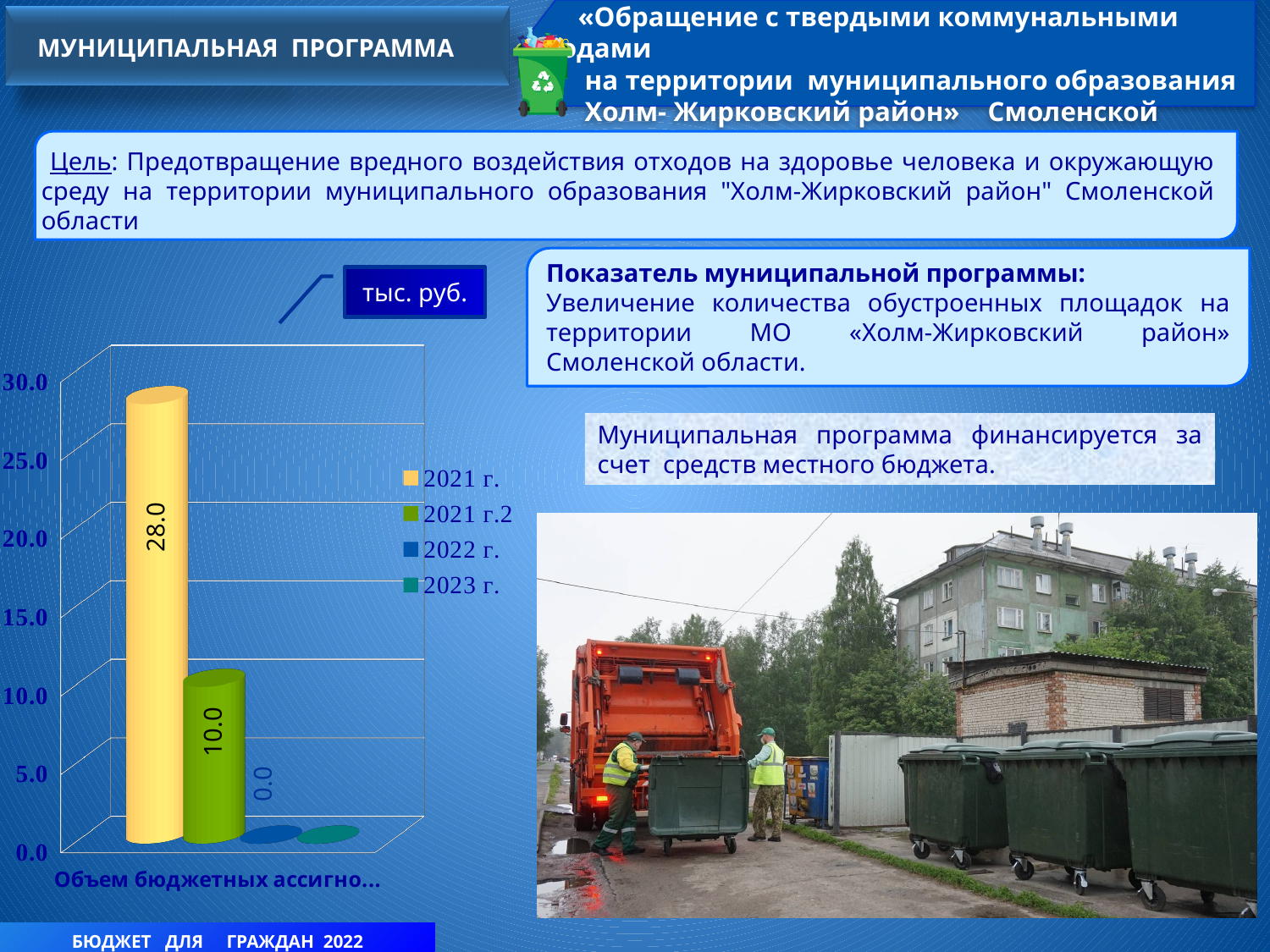
What is the value for the series "2021 г." in the chart? 28.0 Is the value for "2021 г.2" greater or less than 15.0? less What is the difference between the values for "2021 г." and "2021 г.2"? 18.0 Which is larger, the value for "2021 г." or the value for "2021 г.2"? 2021 г. What is the value for the series "2022 г." in the chart? 0.0 What kind of chart is shown on the slide? bar chart Is the value for "2021 г." greater or less than 25.0? greater How many series does the chart legend list? 4 What is the value for the series "2021 г.2" in the chart? 10.0 What is the highest value shown on the chart's vertical axis? 30.0 Which series has the highest value in the chart? 2021 г. What unit of measurement is indicated for the chart values? тыс. руб.